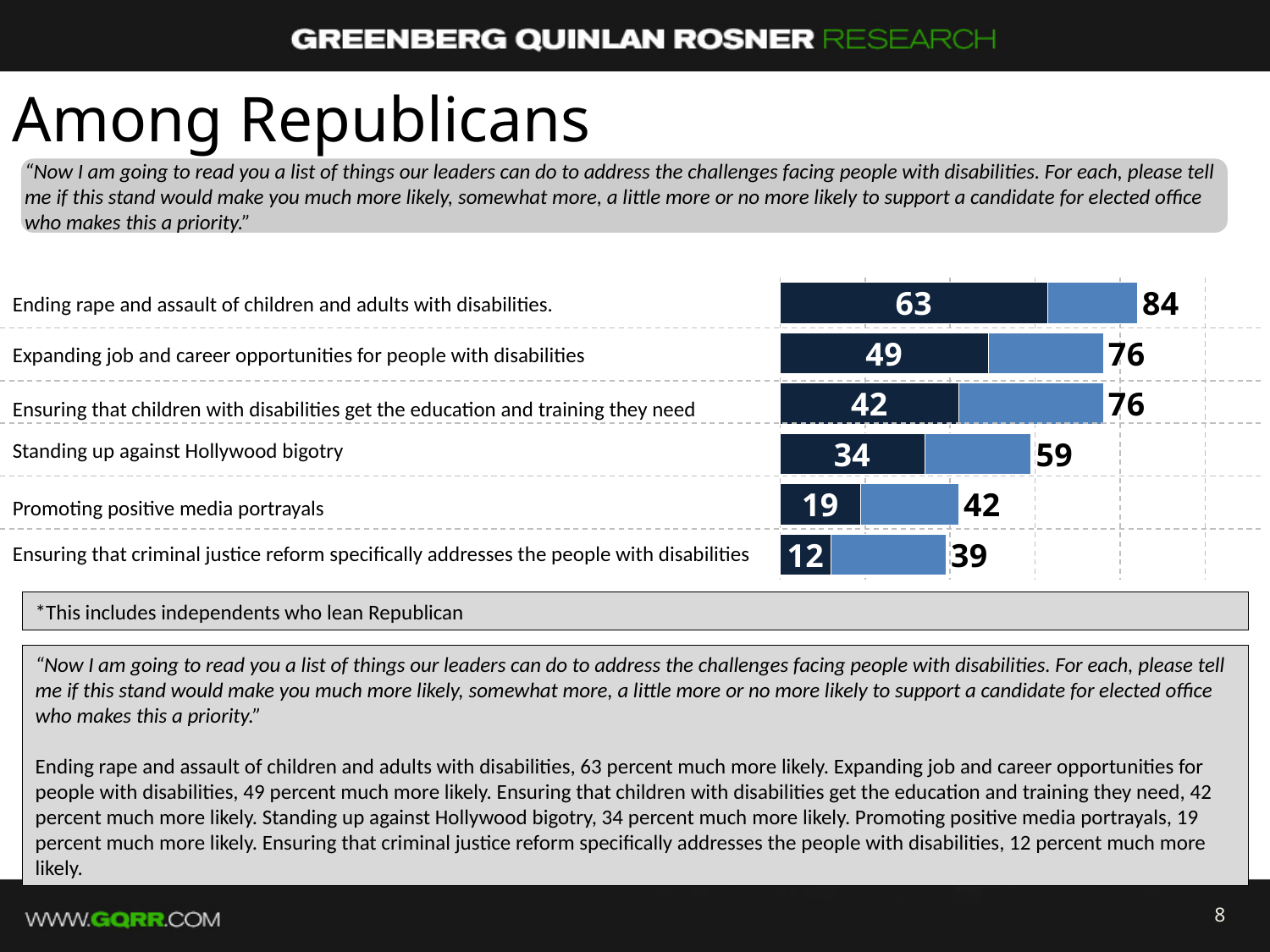
How many categories are shown in the chart? 6 What is the difference between the total value and the dark blue value for "Ensuring that criminal justice reform specifically addresses the people with disabilities"? 27 What is the difference between the dark blue values for "Expanding job and career opportunities for people with disabilities" and "Ensuring that children with disabilities get the education and training they need"? 7 Which category has the highest dark blue (much more likely) value? Ending rape and assault of children and adults with disabilities. What is the dark blue (much more likely) value for "Promoting positive media portrayals"? 19 Which has a larger total value: "Standing up against Hollywood bigotry" or "Promoting positive media portrayals"? Standing up against Hollywood bigotry Which category has the lowest total value at the end of its bar? Ensuring that criminal justice reform specifically addresses the people with disabilities What is the total value shown at the end of the bar for "Ending rape and assault of children and adults with disabilities"? 84 What is the dark blue (much more likely) value for "Ending rape and assault of children and adults with disabilities"? 63 What kind of chart is shown on the slide? Stacked bar chart What is the total value shown at the end of the bar for "Standing up against Hollywood bigotry"? 59 What is the title of the slide containing the chart? Among Republicans